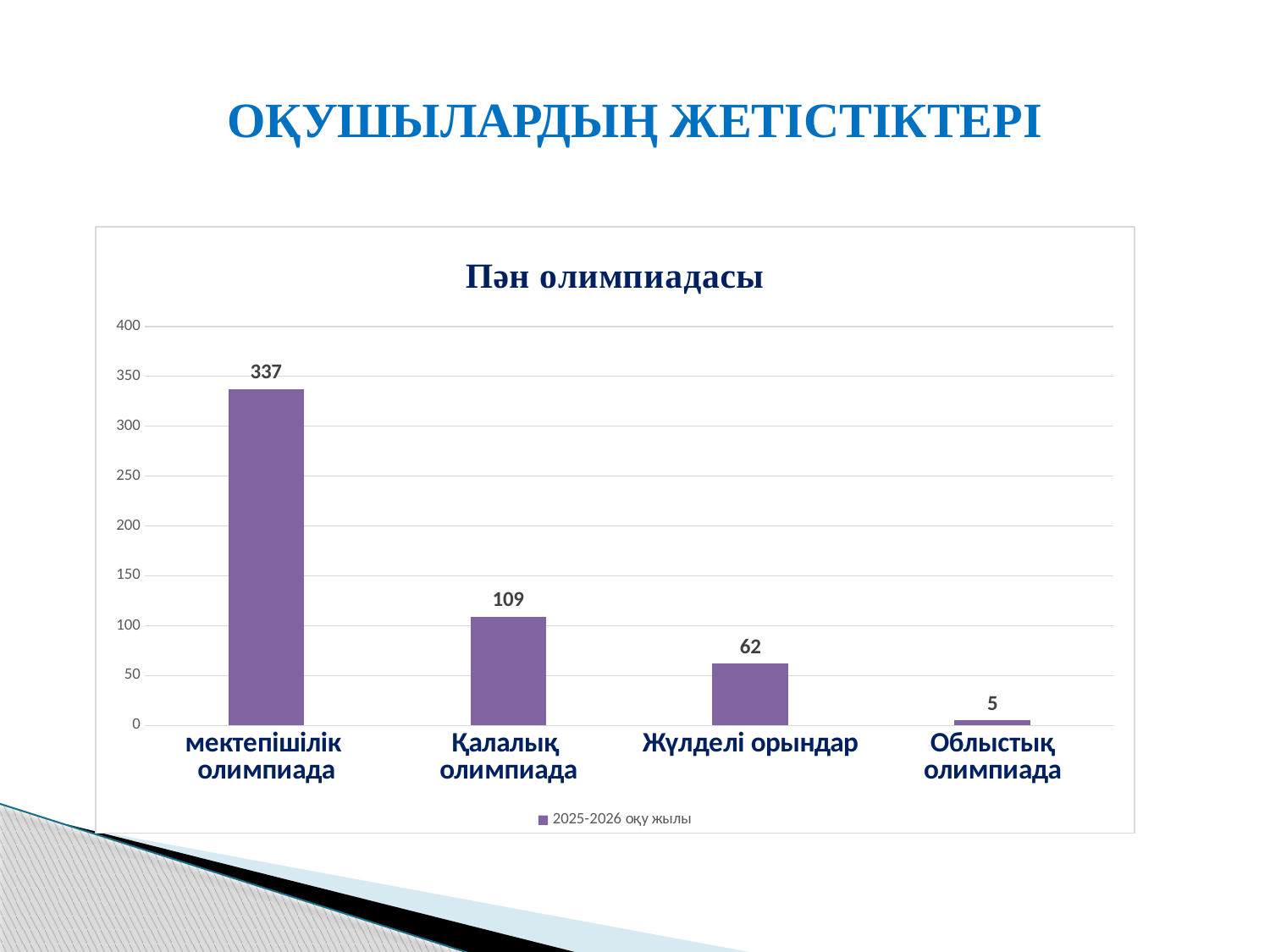
Which is larger, the value for Қалалық олимпиада or the value for Жүлделі орындар? Қалалық олимпиада What is the value for мектепішілік олимпиада? 337 What is the difference between the values for мектепішілік олимпиада and Қалалық олимпиада? 228 Which category has the highest value? мектепішілік олимпиада What is the title of the chart? Пән олимпиадасы What is the value for Қалалық олимпиада? 109 Which category has the lowest value? Облыстық олимпиада What is the value for Облыстық олимпиада? 5 What is the value for Жүлделі орындар? 62 What kind of chart is shown? bar chart How many categories are shown on the x axis? 4 How many series does the legend list? 1